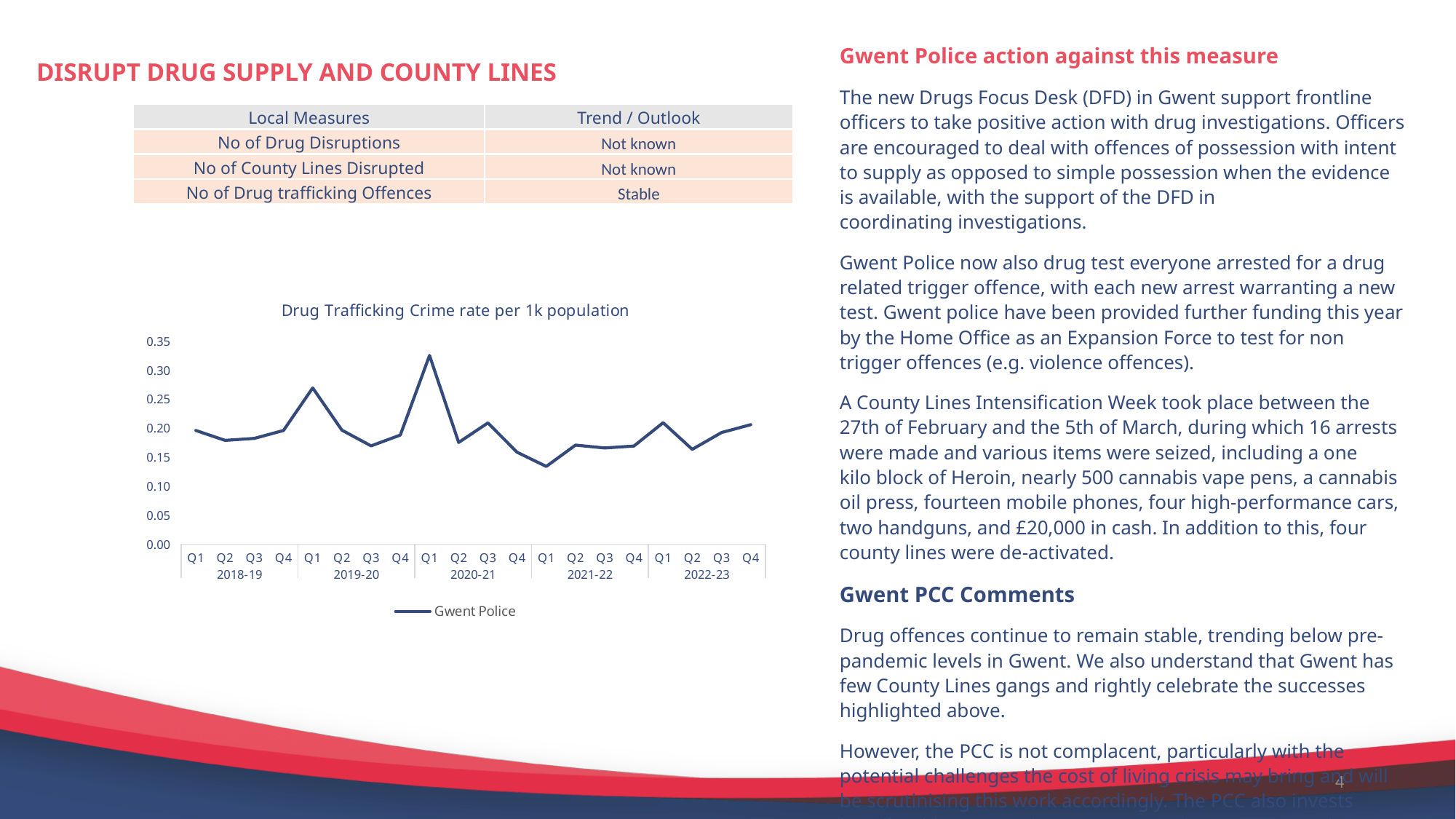
What is the name of the series shown in the legend of the line chart? Gwent Police Is the value for Q1 2020-21 on the line chart greater or less than 0.25? greater Is the value for Q1 2019-20 on the line chart greater or less than 0.20? greater On the line chart, does the value rise or fall between Q1 2020-21 and Q1 2021-22? fall How many quarterly data points are plotted on the 'Drug Trafficking Crime rate per 1k population' chart? 20 On the line chart, which is larger: the value for Q1 2020-21 or the value for Q1 2019-20? Q1 2020-21 In which quarter does the 'Drug Trafficking Crime rate per 1k population' line reach its lowest value? Q1 2021-22 What kind of chart is shown under the title 'Drug Trafficking Crime rate per 1k population'? Line chart How many series does the legend of the 'Drug Trafficking Crime rate per 1k population' chart list? 1 In which quarter does the 'Drug Trafficking Crime rate per 1k population' line reach its highest value? Q1 2020-21 Is the value for Q3 2019-20 on the line chart greater or less than 0.20? less